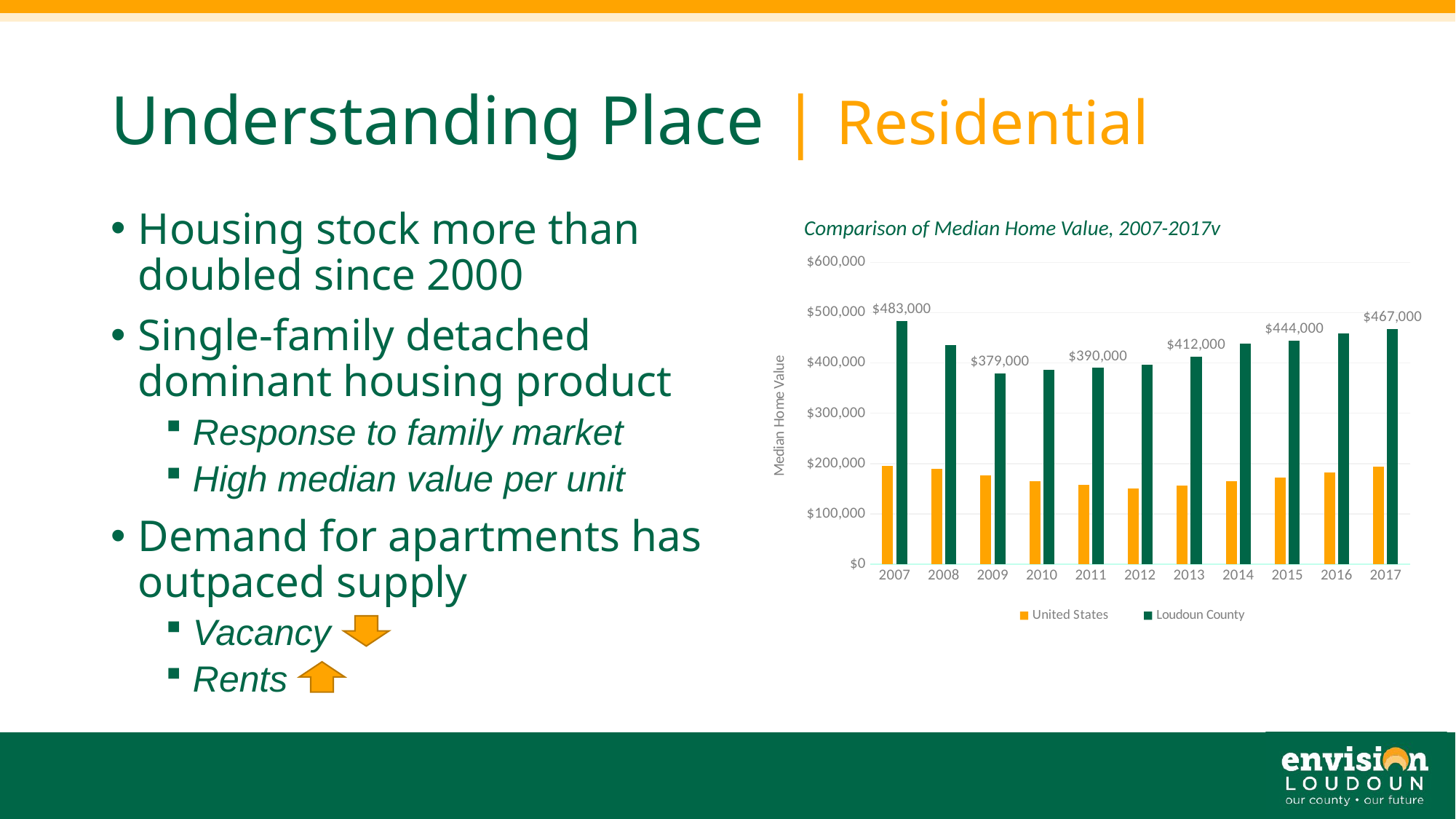
In which year is the Loudoun County median home value lowest? 2009 What is the median home value for Loudoun County in 2009? $379,000 Which is larger, the Loudoun County median home value in 2013 or in 2015? 2015 Is the United States median home value in 2012 greater or less than $200,000? less What is the median home value for Loudoun County in 2013? $412,000 How many series does the chart legend list? 2 What is the median home value for Loudoun County in 2007? $483,000 How many years are shown on the x axis of the chart? 11 What is the median home value for Loudoun County in 2017? $467,000 In which year is the Loudoun County median home value highest? 2007 How much higher is the Loudoun County median home value in 2017 than in 2009? $88,000 What kind of chart is shown on the slide? bar chart